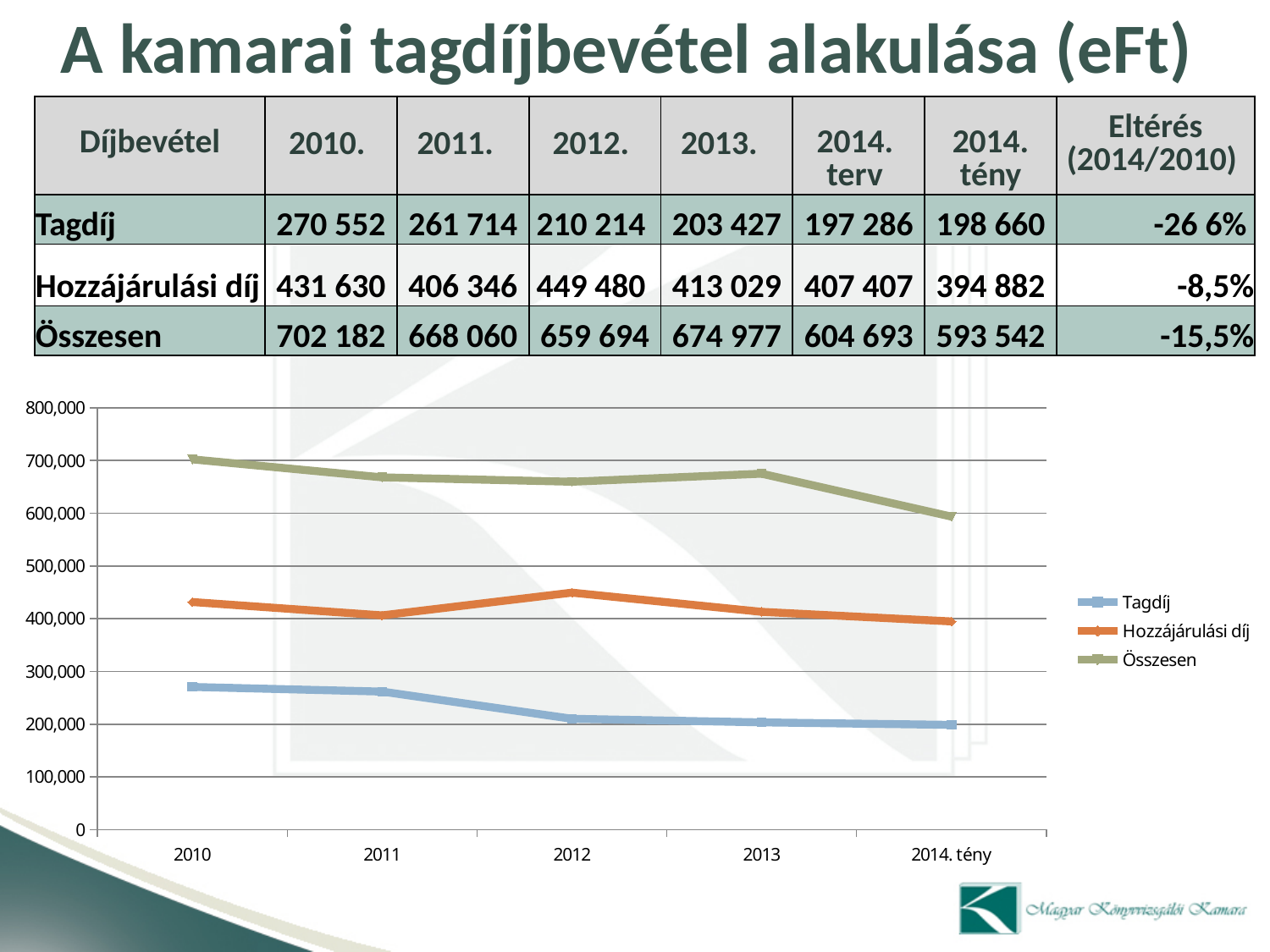
Is the value for Összesen in 2010 greater or less than 700,000? greater Which is larger in 2012: Hozzájárulási díj or Tagdíj? Hozzájárulási díj How many series does the chart legend list? 3 Is the value for Tagdíj in 2014. tény greater or less than 200,000? less Is the value for Hozzájárulási díj in 2012 greater or less than 400,000? greater Which series has the lowest values in the chart? Tagdíj According to the table on the slide, what is the Összesen value for 2013? 674 977 Does the Tagdíj line rise or fall from 2010 to 2014. tény? falls How many points are plotted along the x axis of the chart? 5 What colour is the Összesen line in the chart? green Which series has the highest values in the chart? Összesen What kind of chart is shown on the slide? line chart